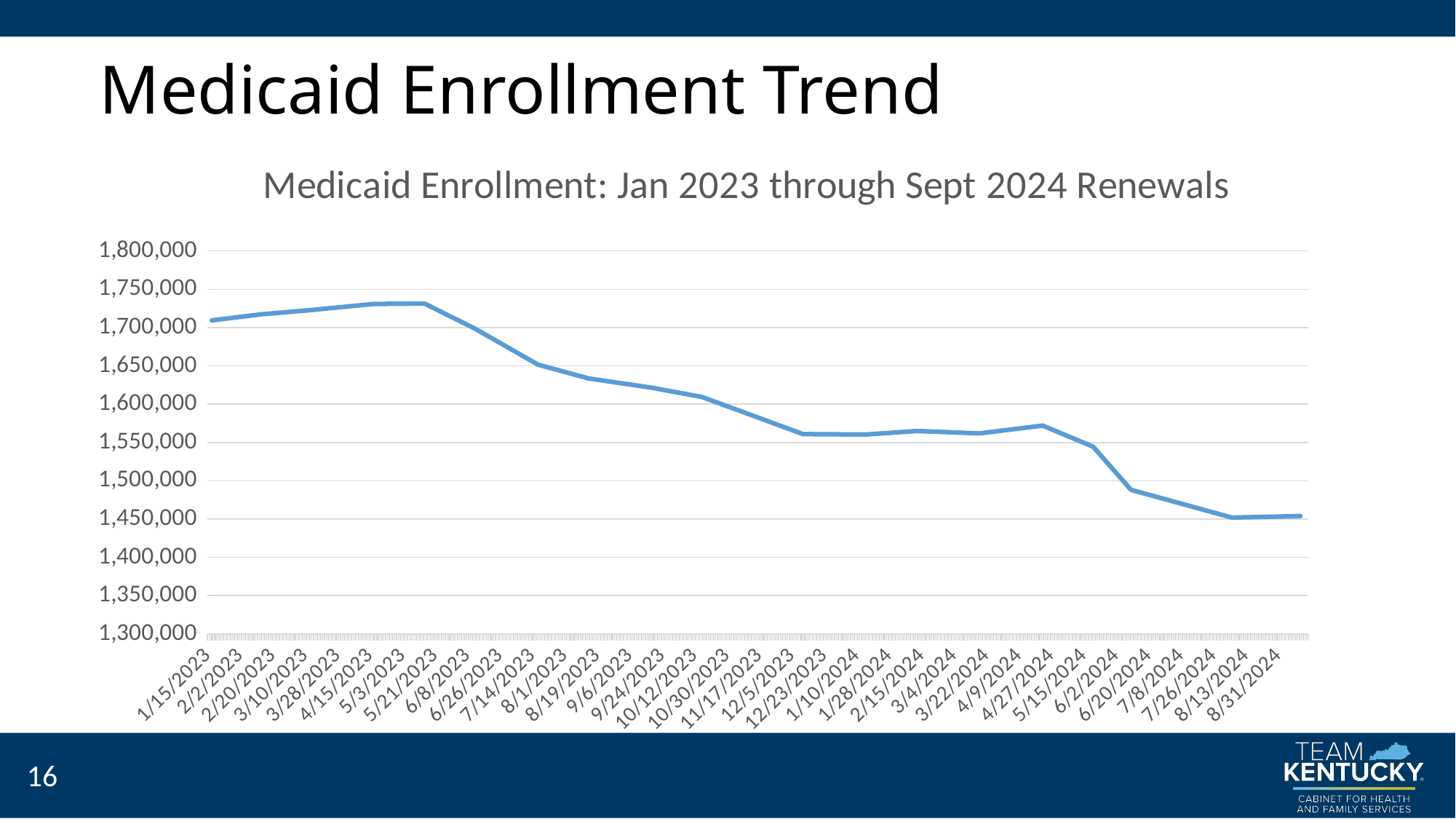
Is the enrollment value at 1/15/2023 greater or less than 1,650,000? greater Is the enrollment value at 5/21/2023 greater or less than 1,700,000? greater Which date has the larger enrollment value, 1/15/2023 or 8/31/2024? 1/15/2023 What is the highest value labeled on the y axis? 1,800,000 Which date has the larger enrollment value, 4/27/2024 or 6/2/2024? 4/27/2024 What is the title of the chart? Medicaid Enrollment: Jan 2023 through Sept 2024 Renewals Around which date does the enrollment line reach its highest point? 5/21/2023 Is the enrollment value at 12/5/2023 greater or less than 1,600,000? less Overall, do the enrollment values rise or fall from left to right along the x axis? fall What kind of chart is shown on the slide? line chart